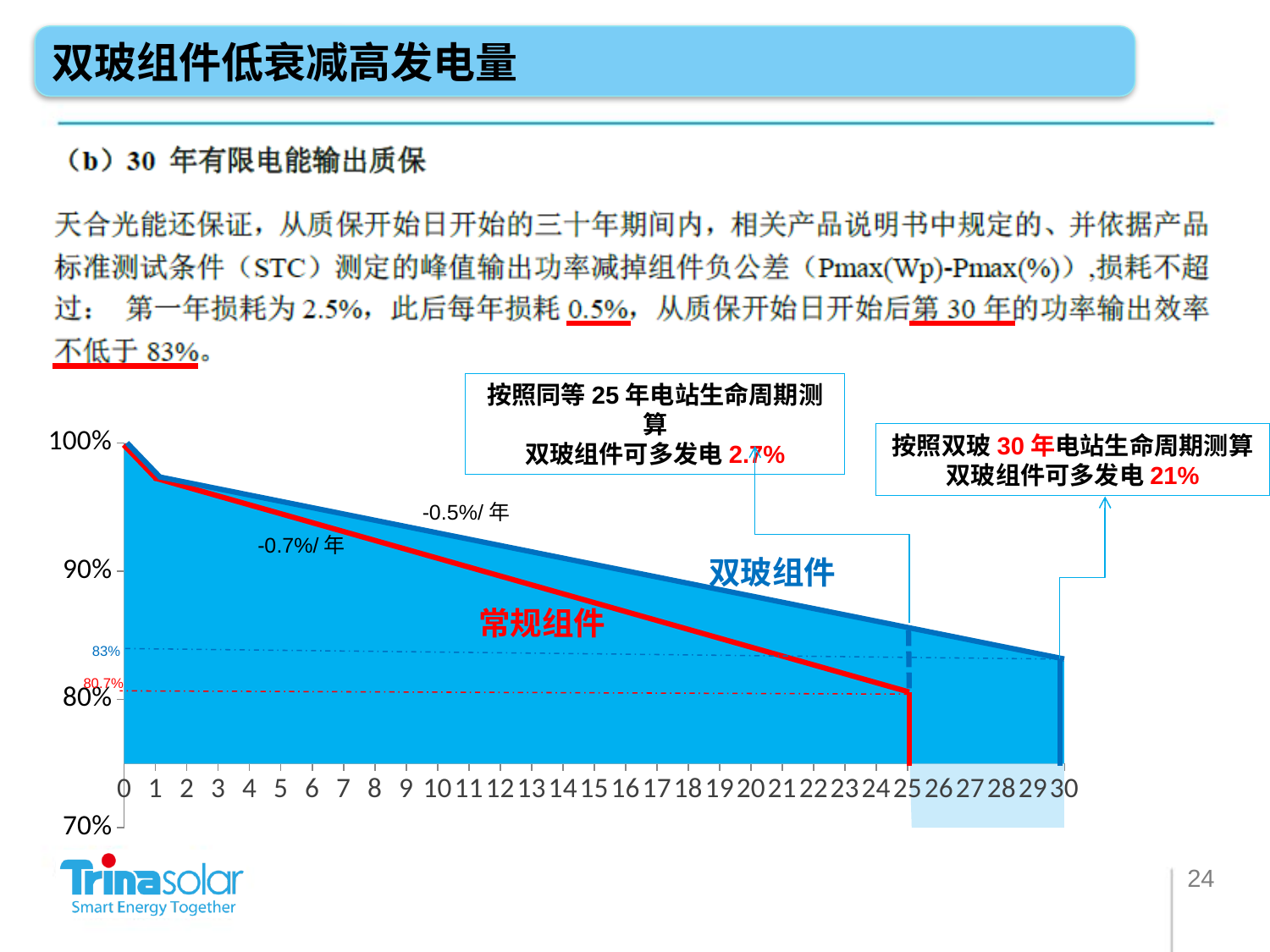
Is the value for 双玻组件 at year 30 greater or less than 80%? greater Which series is drawn in red on the chart? 常规组件 Is the chart on the slide a bar chart or a line chart? line chart According to the annotation, how much more electricity can 双玻组件 generate over a 30-year plant lifecycle? 21% What value is labelled on the dashed line where the 双玻组件 curve ends at year 30? 83% What annual degradation rate is labelled on the chart for 双玻组件? -0.5%/年 What annual degradation rate is labelled on the chart for 常规组件? -0.7%/年 How many series (module types) are plotted on the chart? 2 What value is labelled on the dashed line where the 常规组件 curve ends at year 25? 80.7% Is the value for 常规组件 at year 25 greater or less than 90%? less At year 25, which series has the higher value, 双玻组件 or 常规组件? 双玻组件 Do the plotted values rise or fall as the year increases along the x axis? fall